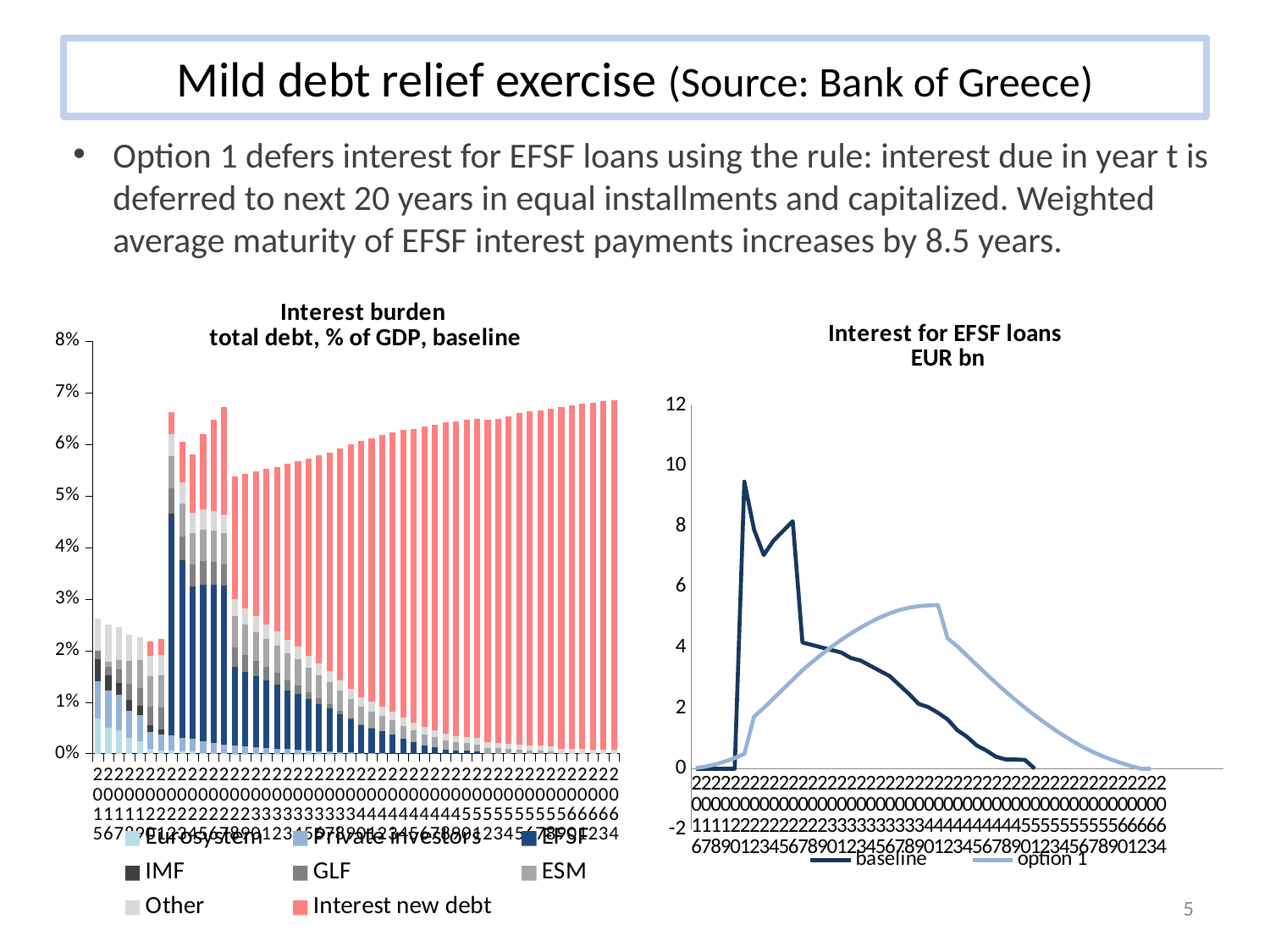
How many series does the legend of the 'Interest burden' chart list? 8 In the 'Interest for EFSF loans' chart, is the peak value of the option 1 series greater or less than 4? greater In the 'Interest burden' chart, is the total of the tallest stacked bar greater or less than 6%? greater In the 'Interest for EFSF loans' chart, does the option 1 series rise or fall over the last part of the x axis? fall In the 'Interest for EFSF loans' chart, is the peak value of the option 1 series greater or less than 6? less What kind of chart is the 'Interest burden total debt, % of GDP, baseline' chart? stacked bar chart How many series does the legend of the 'Interest for EFSF loans' chart list? 2 What unit is shown in the title of the right-hand chart, 'Interest for EFSF loans'? EUR bn What kind of chart is the 'Interest for EFSF loans EUR bn' chart? line chart In the 'Interest burden' chart, does the 'Interest new debt' component rise or fall over the later years along the x axis? rise In the 'Interest for EFSF loans' chart, which series reaches the higher peak value, baseline or option 1? baseline